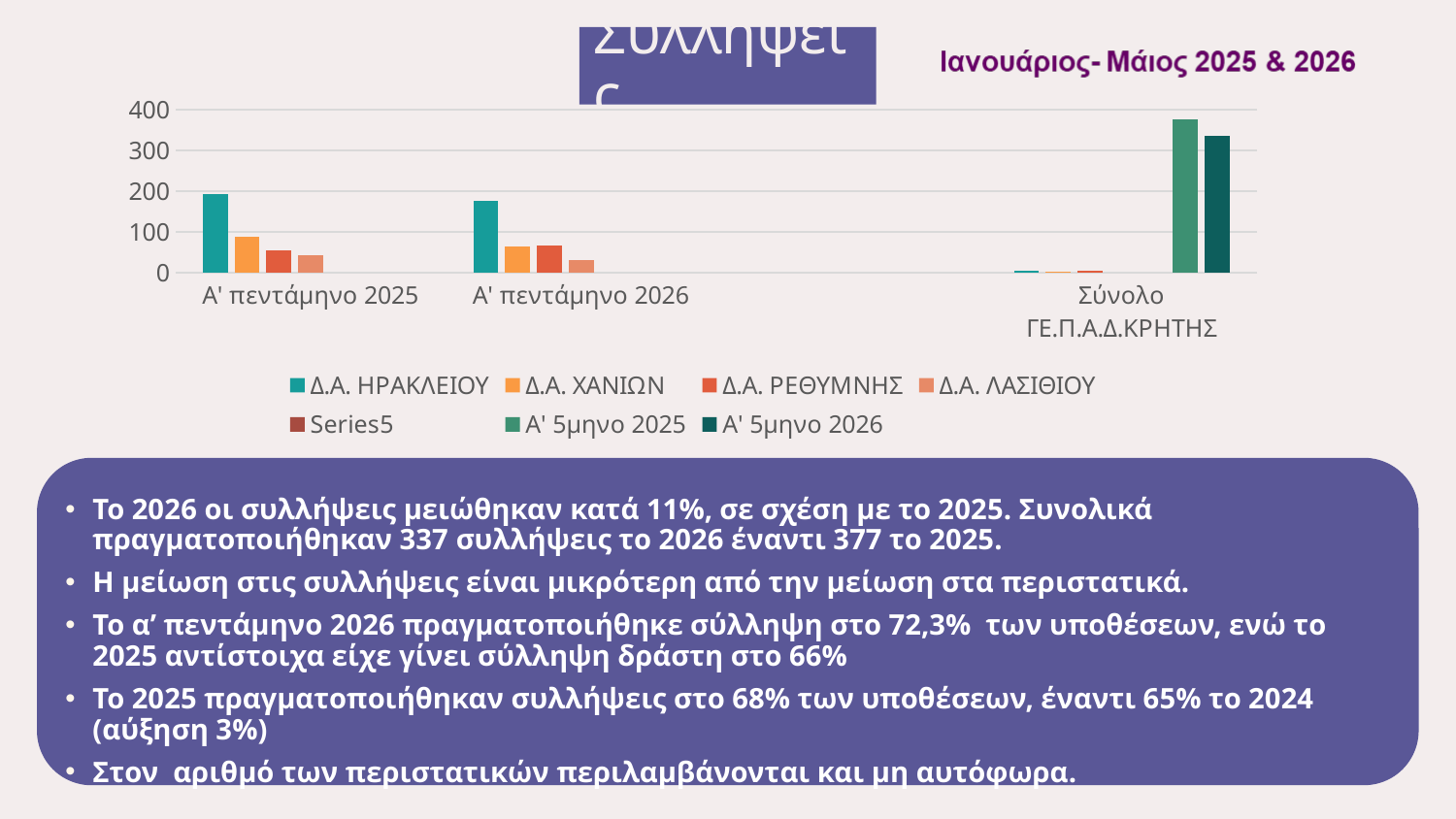
How many categories are shown along the x axis? 3 In Α' πεντάμηνο 2025, which is larger: Δ.Α. ΗΡΑΚΛΕΙΟΥ or Δ.Α. ΧΑΝΙΩΝ? Δ.Α. ΗΡΑΚΛΕΙΟΥ Is the value for Α' 5μηνο 2025 in Σύνολο ΓΕ.Π.Α.Δ.ΚΡΗΤΗΣ greater or less than 300? greater What kind of chart is shown on the slide? bar chart Is the value for Δ.Α. ΗΡΑΚΛΕΙΟΥ in Α' πεντάμηνο 2025 greater or less than 100? greater In Σύνολο ΓΕ.Π.Α.Δ.ΚΡΗΤΗΣ, which is larger: Α' 5μηνο 2025 or Α' 5μηνο 2026? Α' 5μηνο 2025 Does the value for Δ.Α. ΗΡΑΚΛΕΙΟΥ rise or fall from Α' πεντάμηνο 2025 to Α' πεντάμηνο 2026? fall Which series has the lowest value in Α' πεντάμηνο 2026? Δ.Α. ΛΑΣΙΘΙΟΥ Is the value for Δ.Α. ΗΡΑΚΛΕΙΟΥ in Α' πεντάμηνο 2026 greater or less than 100? greater Which series has the highest value in Α' πεντάμηνο 2026? Δ.Α. ΗΡΑΚΛΕΙΟΥ How many series does the legend list? 7